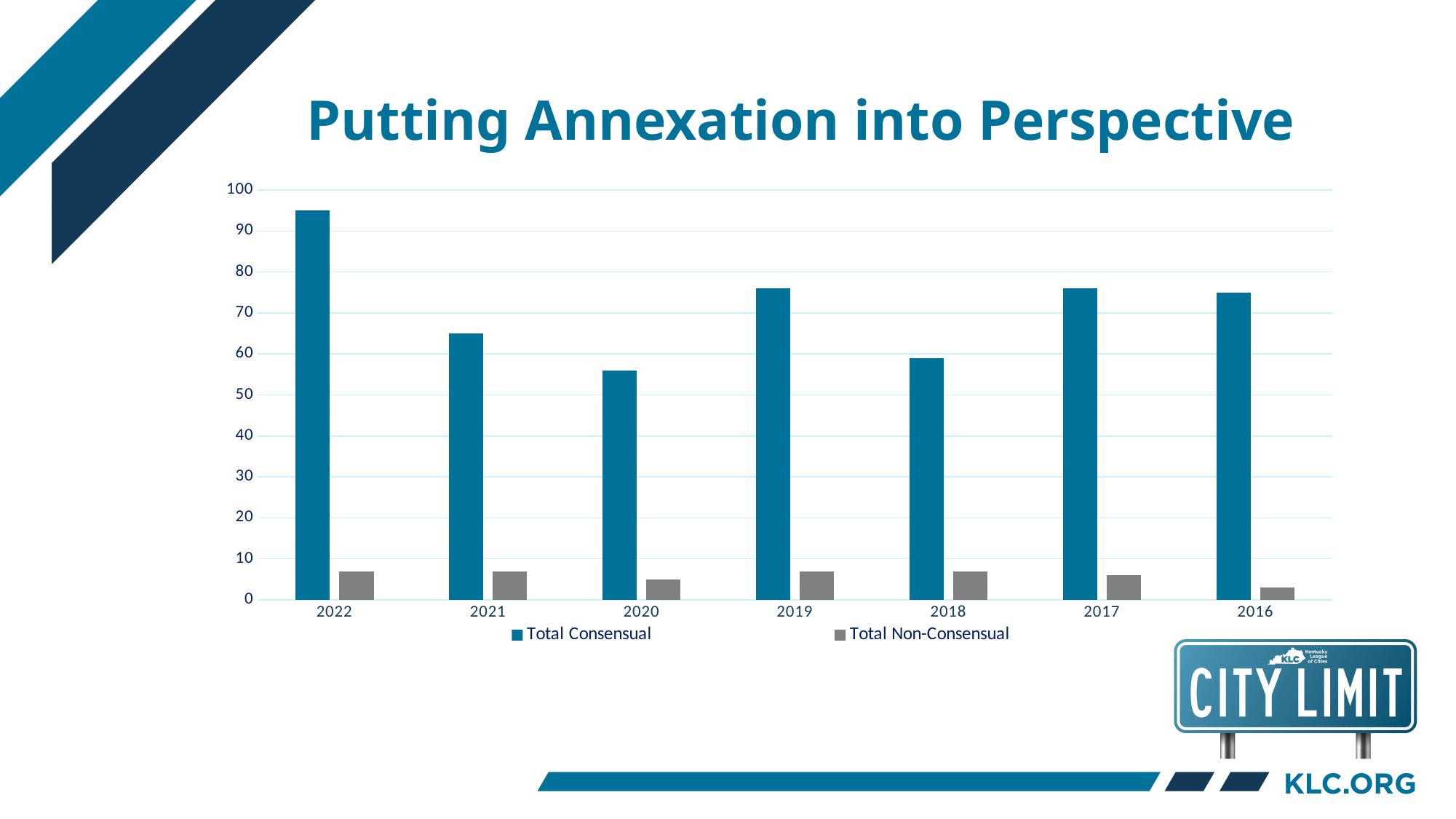
Which year has the lowest Total Non-Consensual value? 2016 What are the two series named in the legend? Total Consensual and Total Non-Consensual Is the Total Consensual value for 2020 greater or less than 60? less Which is larger, the Total Consensual value for 2019 or for 2020? 2019 What kind of chart is shown on the slide? bar chart Which is larger, the Total Consensual value for 2022 or for 2021? 2022 Is the Total Consensual value for 2022 greater or less than 90? greater How many series does the legend list? 2 What is the title of the chart? Putting Annexation into Perspective Which year has the highest Total Consensual value? 2022 Is the Total Consensual value for 2019 greater or less than 70? greater How many years are shown on the x axis? 7